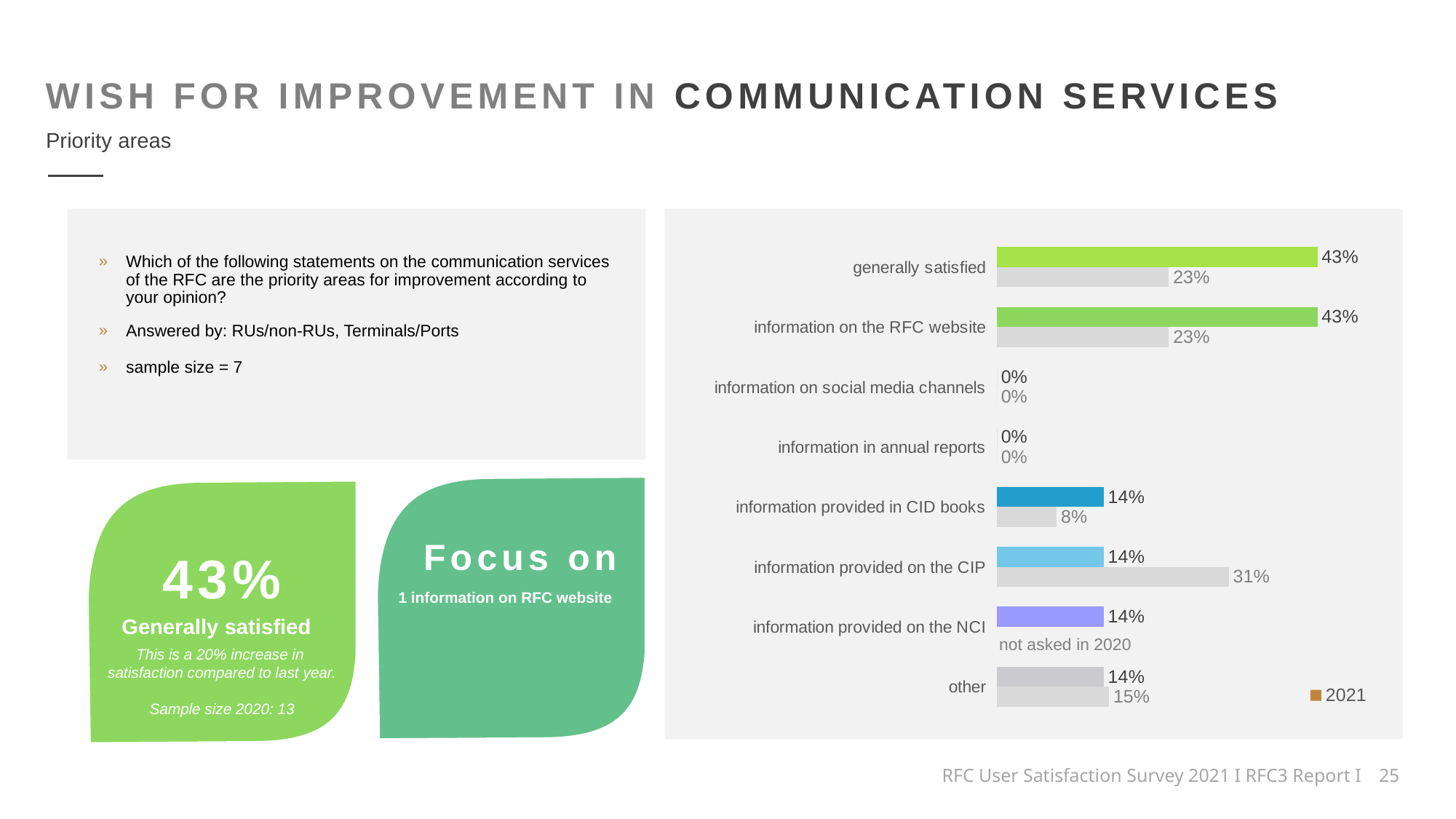
What is the difference between the 2021 and 2020 values for "generally satisfied"? 20% What is the 2020 value for "information provided on the CIP"? 31% Which is larger for "information provided in CID books": the 2021 value or the 2020 value? 2021 What is shown for the 2020 value of "information provided on the NCI"? not asked in 2020 What is the 2021 value for "other"? 14% What is the 2021 value for "information on the RFC website"? 43% What is the difference between the 2020 and 2021 values for "information provided on the CIP"? 17% What kind of chart is shown on the slide? bar chart How many categories are shown on the chart? 8 Which category has the highest 2020 value? information provided on the CIP Which series is listed in the chart legend? 2021 What is the 2020 value for "information provided in CID books"? 8%